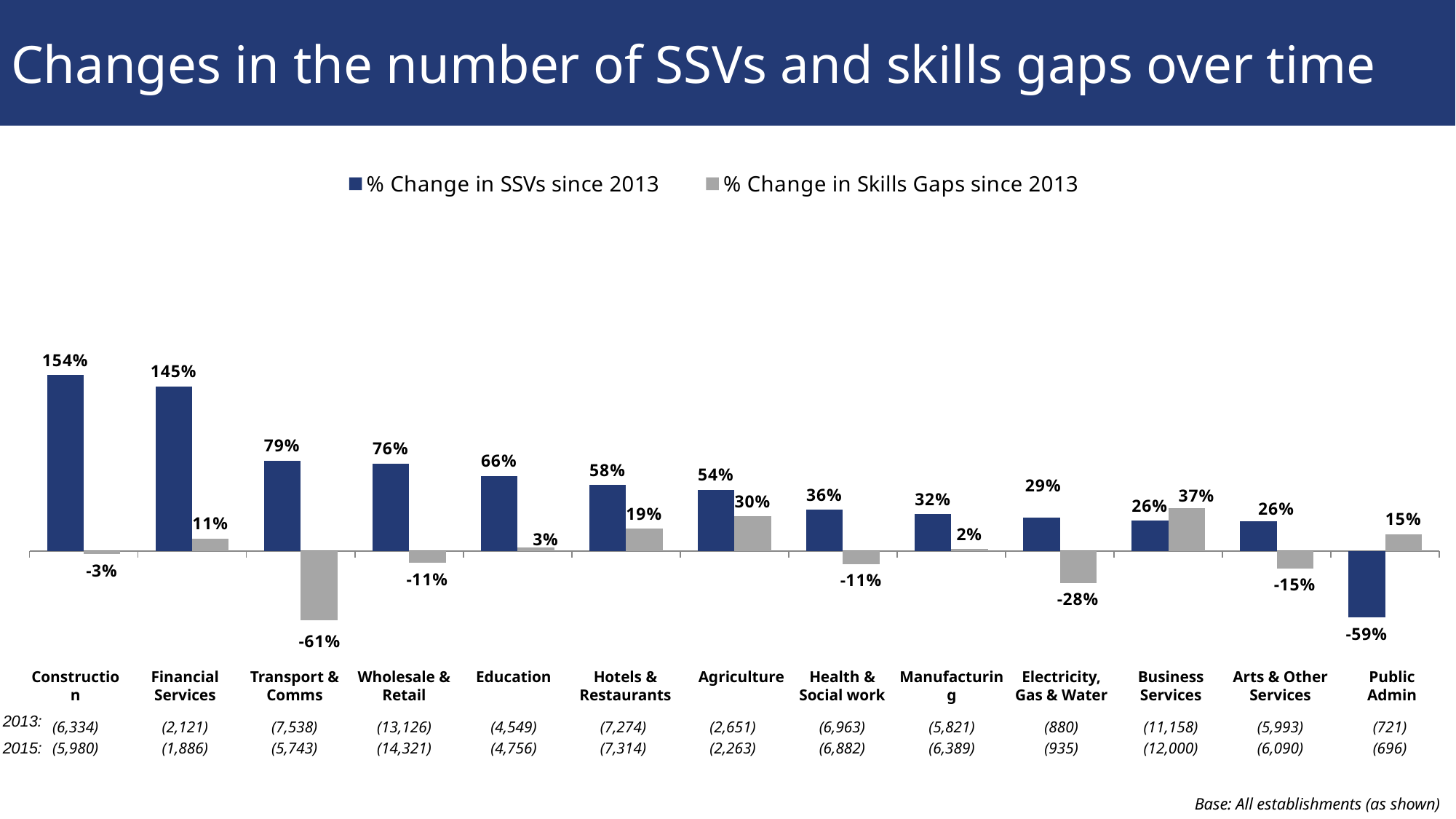
Which sector has the lowest % change in Skills Gaps since 2013? Transport & Comms Which sector has the highest % change in SSVs since 2013? Construction How many series does the legend list? 2 What is the % change in Skills Gaps since 2013 for Business Services? 37% What is the % change in SSVs since 2013 for Construction? 154% What is the difference between the % change in SSVs for Construction and Financial Services? 9 percentage points How many sectors are shown on the x axis? 13 Which is larger for Business Services: the % change in SSVs or the % change in Skills Gaps? % Change in Skills Gaps since 2013 Which sector has the lowest % change in SSVs since 2013? Public Admin What is the title of the slide? Changes in the number of SSVs and skills gaps over time What is the % change in Skills Gaps since 2013 for Transport & Comms? -61% What kind of chart is shown on the slide? Bar chart